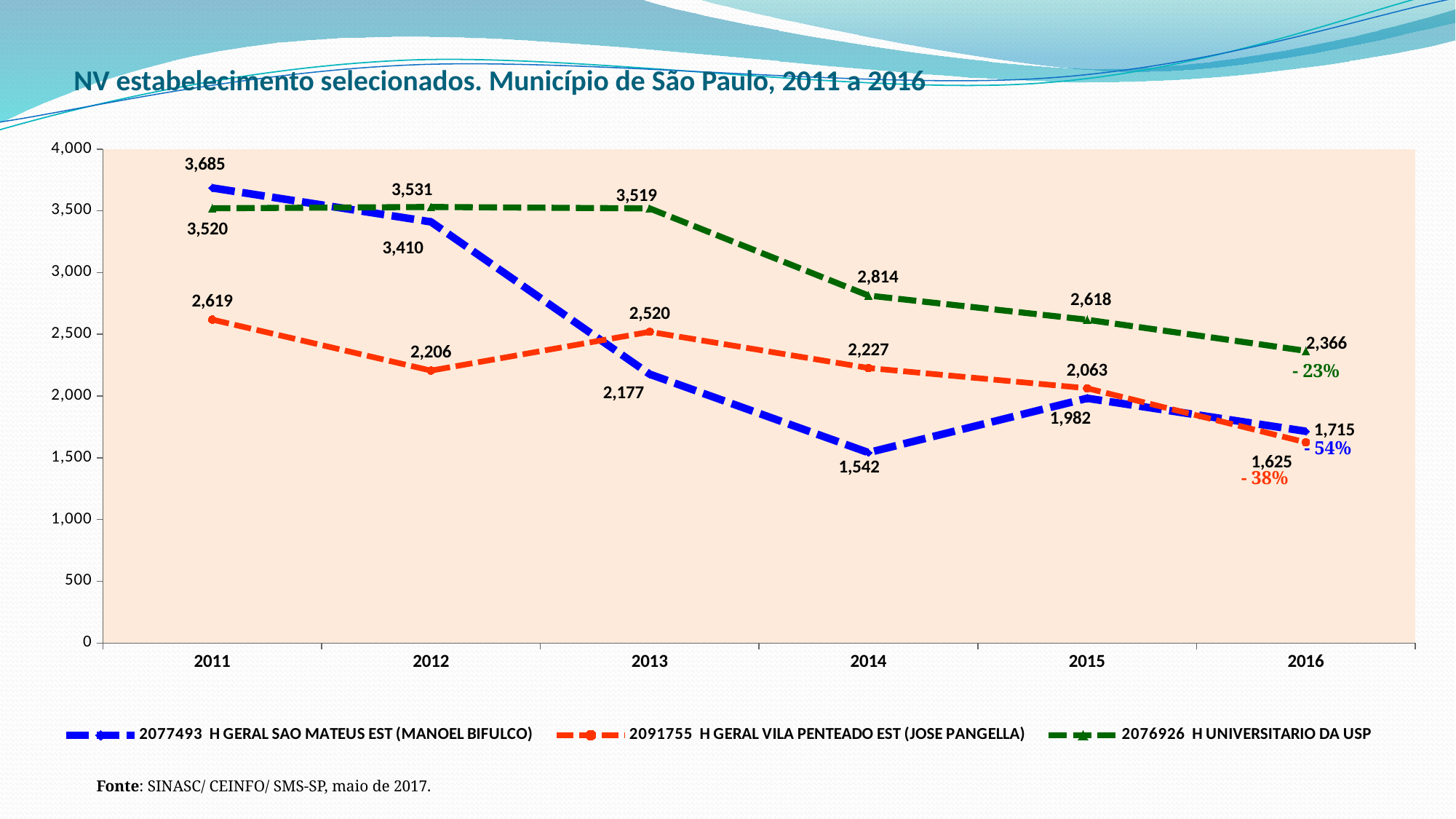
What is the value for 2077493 H GERAL SAO MATEUS EST (MANOEL BIFULCO) in 2011? 3,685 What is the difference between the 2011 and 2016 values for 2076926 H UNIVERSITARIO DA USP? 1,154 In which year does 2077493 H GERAL SAO MATEUS EST (MANOEL BIFULCO) have its highest value? 2011 What is the value for 2091755 H GERAL VILA PENTEADO EST (JOSE PANGELLA) in 2015? 2,063 What kind of chart is shown on the slide? Line chart How many years are shown on the x axis? 6 Does the value for 2076926 H UNIVERSITARIO DA USP rise or fall from 2013 to 2016? Fall In 2016, which has the larger value: 2077493 H GERAL SAO MATEUS EST (MANOEL BIFULCO) or 2091755 H GERAL VILA PENTEADO EST (JOSE PANGELLA)? 2077493 H GERAL SAO MATEUS EST (MANOEL BIFULCO) How many series does the legend list? 3 In which year does 2077493 H GERAL SAO MATEUS EST (MANOEL BIFULCO) have its lowest value? 2014 What is the value for 2091755 H GERAL VILA PENTEADO EST (JOSE PANGELLA) in 2013? 2,520 What is the value for 2076926 H UNIVERSITARIO DA USP in 2014? 2,814